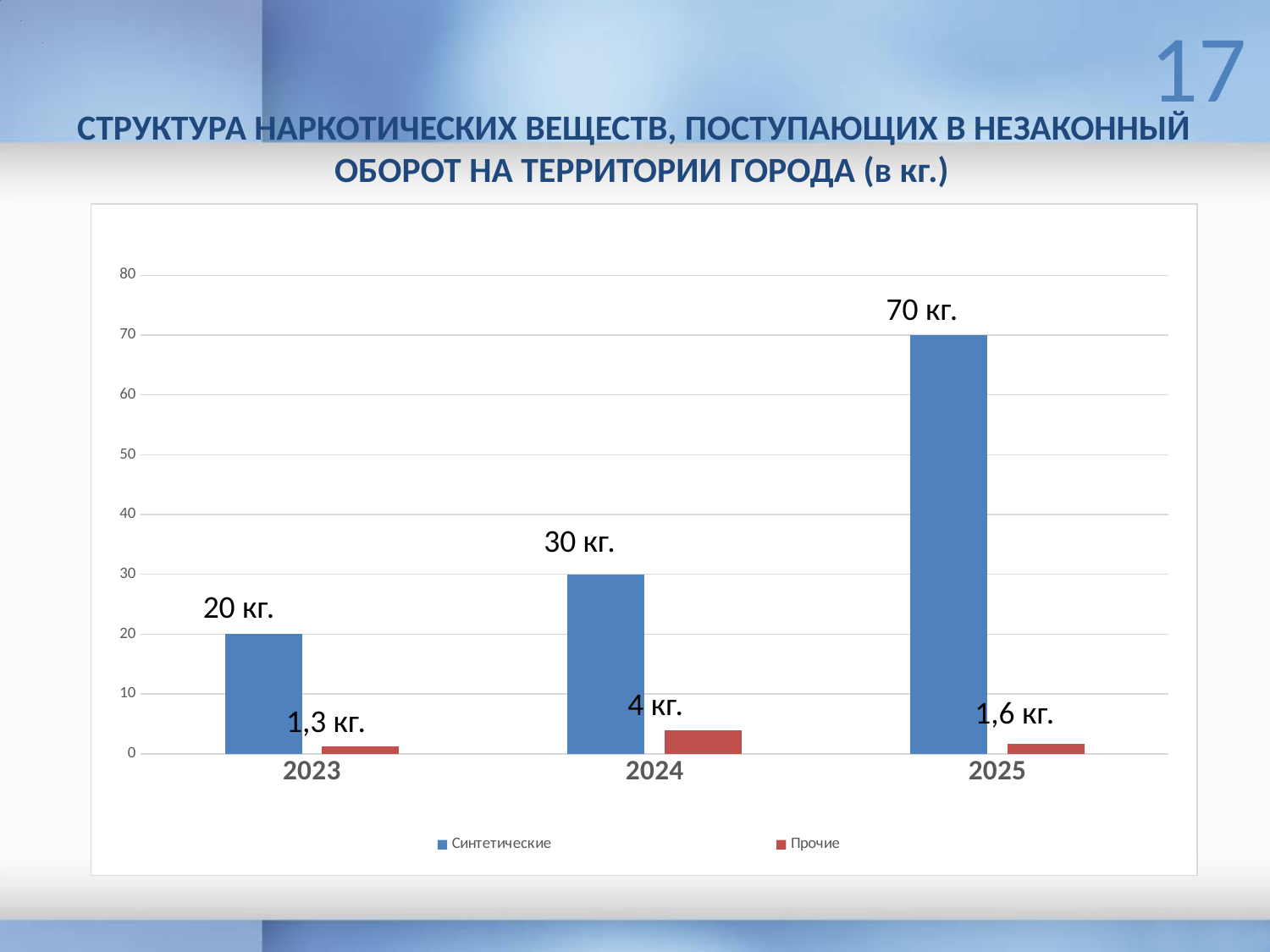
How many years are shown on the x axis? 3 Which year has the lowest value for Прочие? 2023 What is the value for Прочие in 2023? 1,3 кг. What kind of chart is shown on the slide? bar chart Is the value for Синтетические in 2024 greater or less than 40? less What is the value for Прочие in 2024? 4 кг. What is the value for Синтетические in 2025? 70 кг. Which year has the highest value for Синтетические? 2025 How many series does the legend list? 2 Do the Синтетические values rise or fall from 2023 to 2025? rise Which is larger: Прочие in 2024 or Прочие in 2025? Прочие in 2024 What is the difference between the Синтетические values for 2025 and 2024? 40 кг.